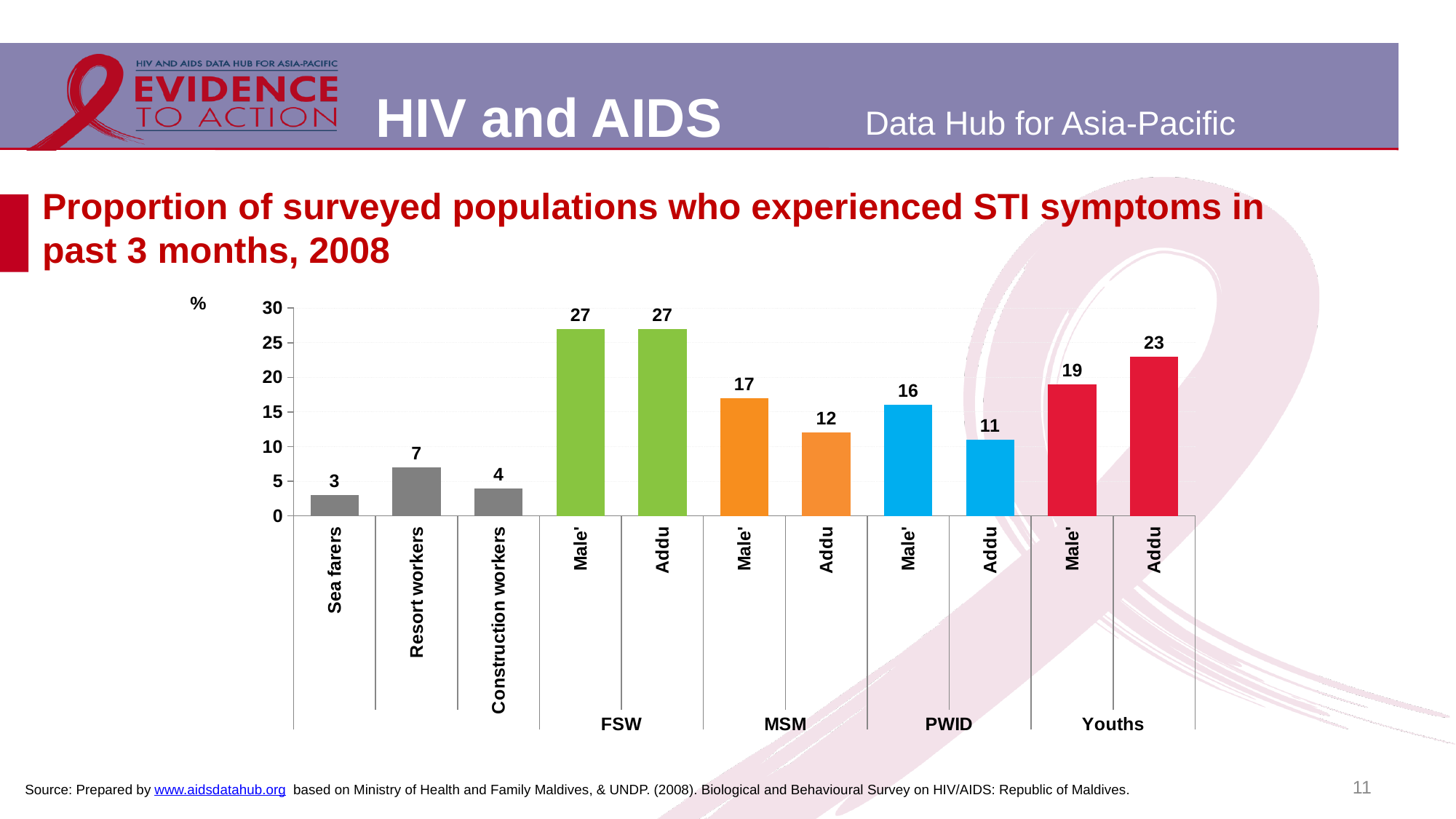
What is the difference between the values for PWID Male' and PWID Addu? 5 What is the highest value shown on the chart? 27 What is the value for MSM in Addu? 12 How many bars are plotted on the chart? 11 What is the value for Youths in Addu? 23 What is the difference between the values for Construction workers and Resort workers? 3 Which group has the lowest proportion who experienced STI symptoms? Sea farers Which is larger: the value for MSM Male' or the value for Youths Male'? Youths Male' What kind of chart is shown on the slide? Bar chart What is the value for Resort workers? 7 What is the maximum value shown on the y axis? 30 What is the value for Sea farers? 3